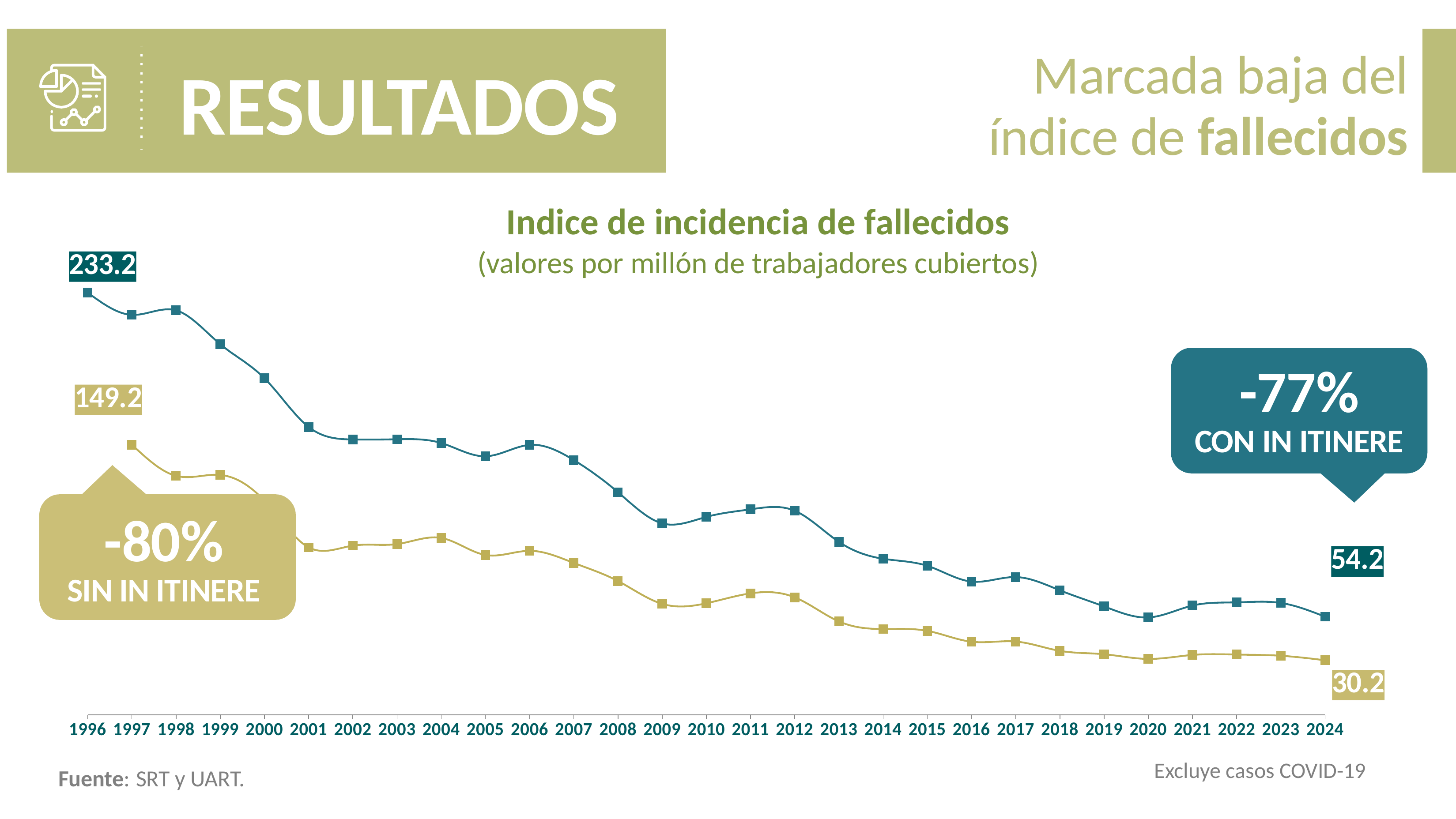
Which series has the higher value in 2024, CON IN ITINERE or SIN IN ITINERE? CON IN ITINERE What is the value of the CON IN ITINERE series in 2024? 54.2 By how much did the CON IN ITINERE index fall between 1996 and 2024? 179.0 Do the values of the CON IN ITINERE series rise or fall from 1996 to 2024? fall What percentage change does the callout give for the CON IN ITINERE series? -77% What kind of chart is shown on the slide? line chart How many years are shown on the x axis? 29 What is the value of the CON IN ITINERE series in 1996? 233.2 What is the first labelled value of the SIN IN ITINERE series? 149.2 What is the difference between the CON IN ITINERE and SIN IN ITINERE values in 2024? 24.0 What is the value of the SIN IN ITINERE series in 2024? 30.2 How many series (lines) are plotted on the chart? 2